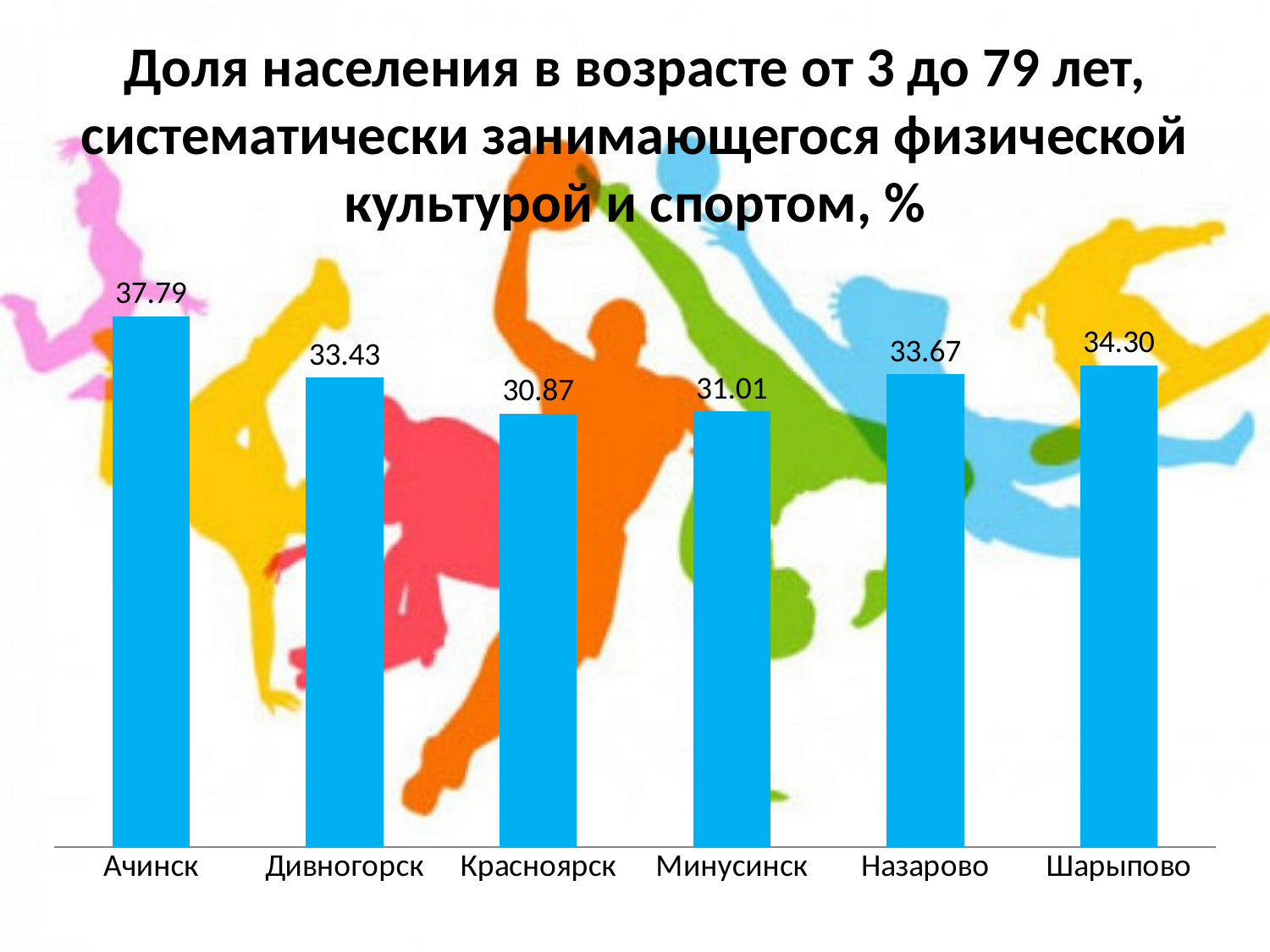
What is the difference between the values for Ачинск and Красноярск? 6.92 Which city has the lowest value? Красноярск What is the value for Красноярск? 30.87 What kind of chart is this? bar chart What is the value for Ачинск? 37.79 What is the value for Шарыпово? 34.30 What is the title of the chart? Доля населения в возрасте от 3 до 79 лет, систематически занимающегося физической культурой и спортом, % Which is larger, the value for Дивногорск or the value for Минусинск? Дивногорск What is the difference between the values for Шарыпово and Назарово? 0.63 How many cities are shown on the chart? 6 What is the value for Назарово? 33.67 Which city has the highest value? Ачинск